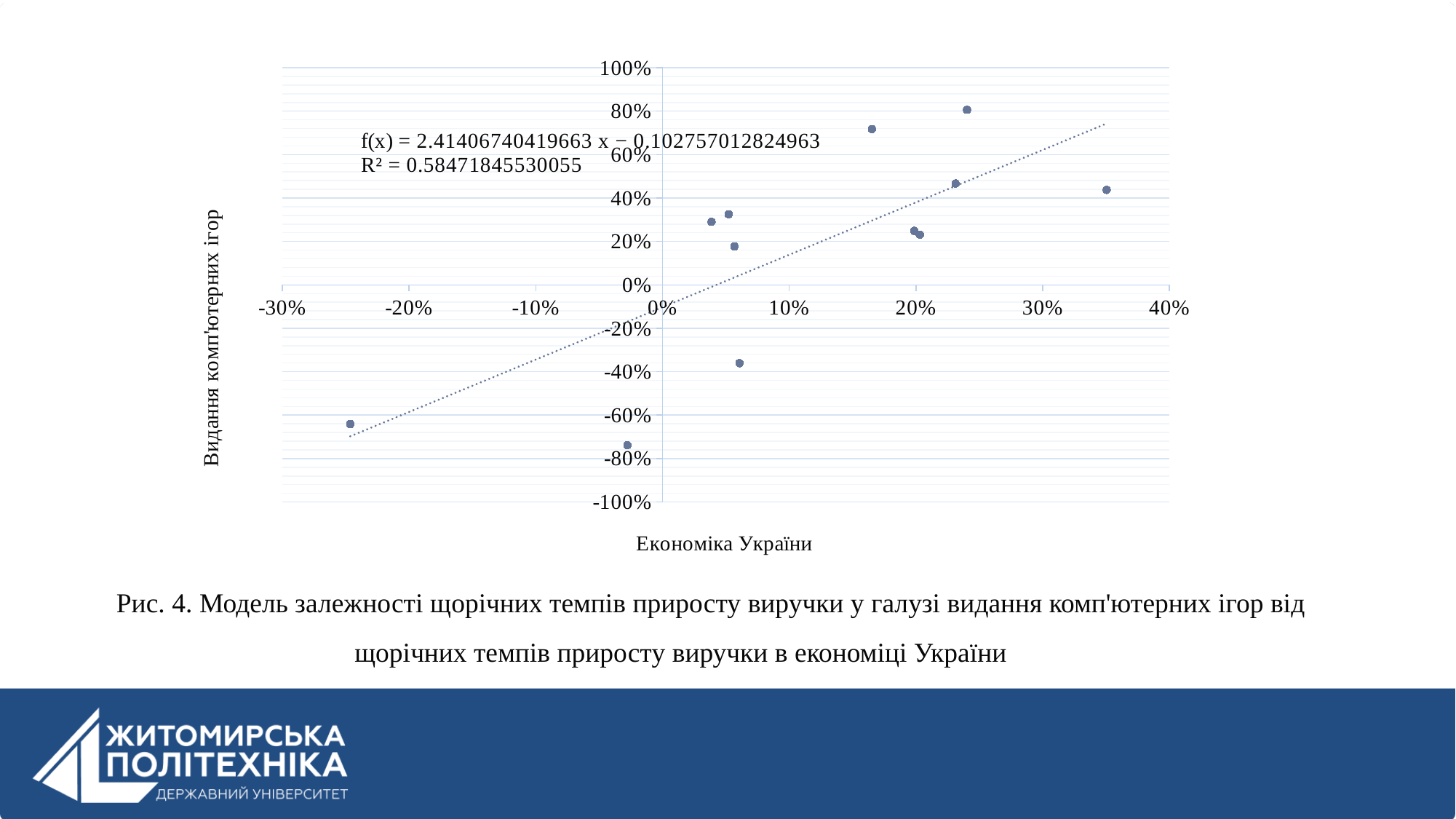
What is the title of the horizontal axis of the chart? Економіка України What is the maximum value shown on the vertical axis of the chart? 100% What kind of chart is shown on the slide? scatter chart What is the title of the vertical axis of the chart? Видання комп'ютерних ігор Which has the larger vertical-axis value: the point near 24% on the horizontal axis or the point near 35% on the horizontal axis? the point near 24% Is the vertical-axis value of the lowest point on the chart greater or less than -60%? less Is the horizontal-axis value of the rightmost point on the chart greater or less than 30%? greater Is the horizontal-axis value of the leftmost point on the chart greater or less than -20%? less What is the slope coefficient in the trendline equation printed on the chart? 2.41406740419663 What R² value is printed on the chart? R² = 0.58471845530055 According to the dotted trendline, do the values on the vertical axis rise or fall as the horizontal-axis values increase? rise